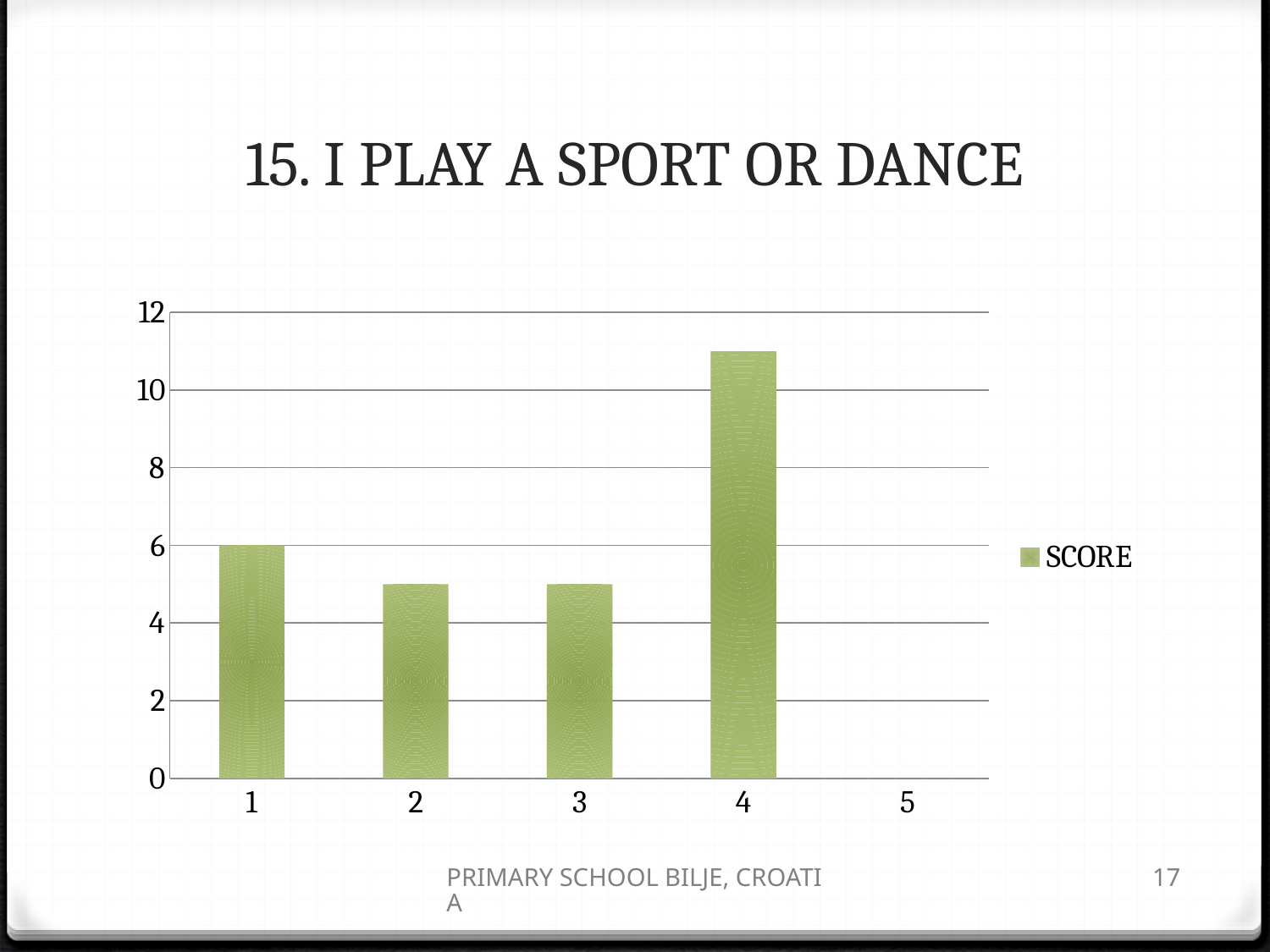
What is the value for category 1? 6 How many series does the legend list? 1 Is the value for category 4 greater or less than 10? greater Is the value for category 3 greater or less than 4? greater Is the value for category 2 greater or less than 6? less Which is larger, the value for category 1 or the value for category 4? category 4 What is the name of the series shown in the legend? SCORE What kind of chart is shown on the slide? bar chart Which category has the lowest value? 5 How many categories are shown on the x axis? 5 Which category has the highest value? 4 What is the value for category 5? 0